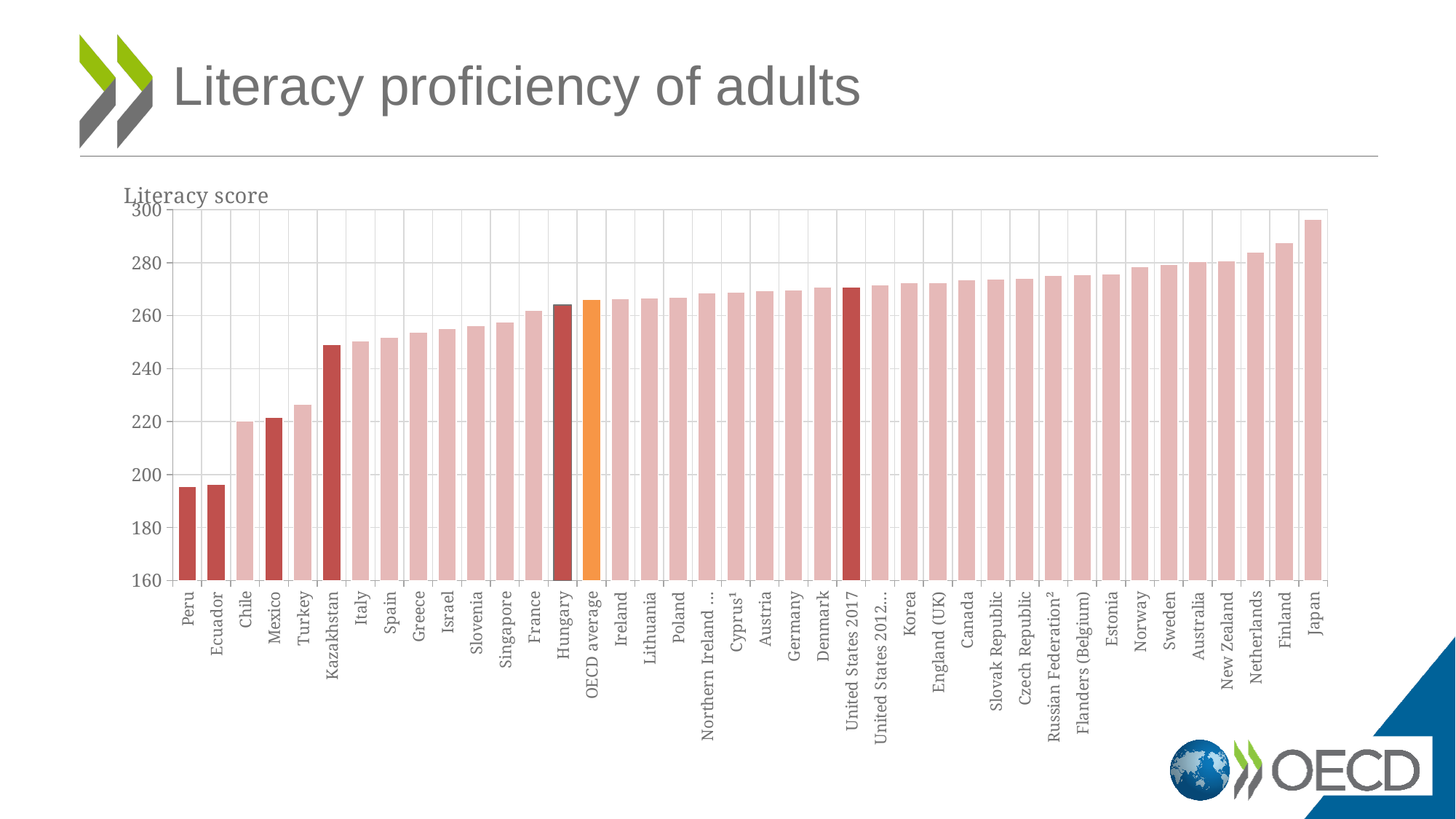
Is the value for Kazakhstan greater or less than 240? greater How many categories (bars) are plotted in the chart? 40 Is the value for Korea greater or less than 280? less Is the value for Peru greater or less than 200? less Which has the larger literacy score, Japan or Finland? Japan Which has the larger literacy score, Kazakhstan or Turkey? Kazakhstan Which category has the highest literacy score? Japan What kind of chart is shown on the slide? bar chart Do the values generally rise or fall from left to right along the x axis? rise What is the label on the vertical axis of the chart? Literacy score